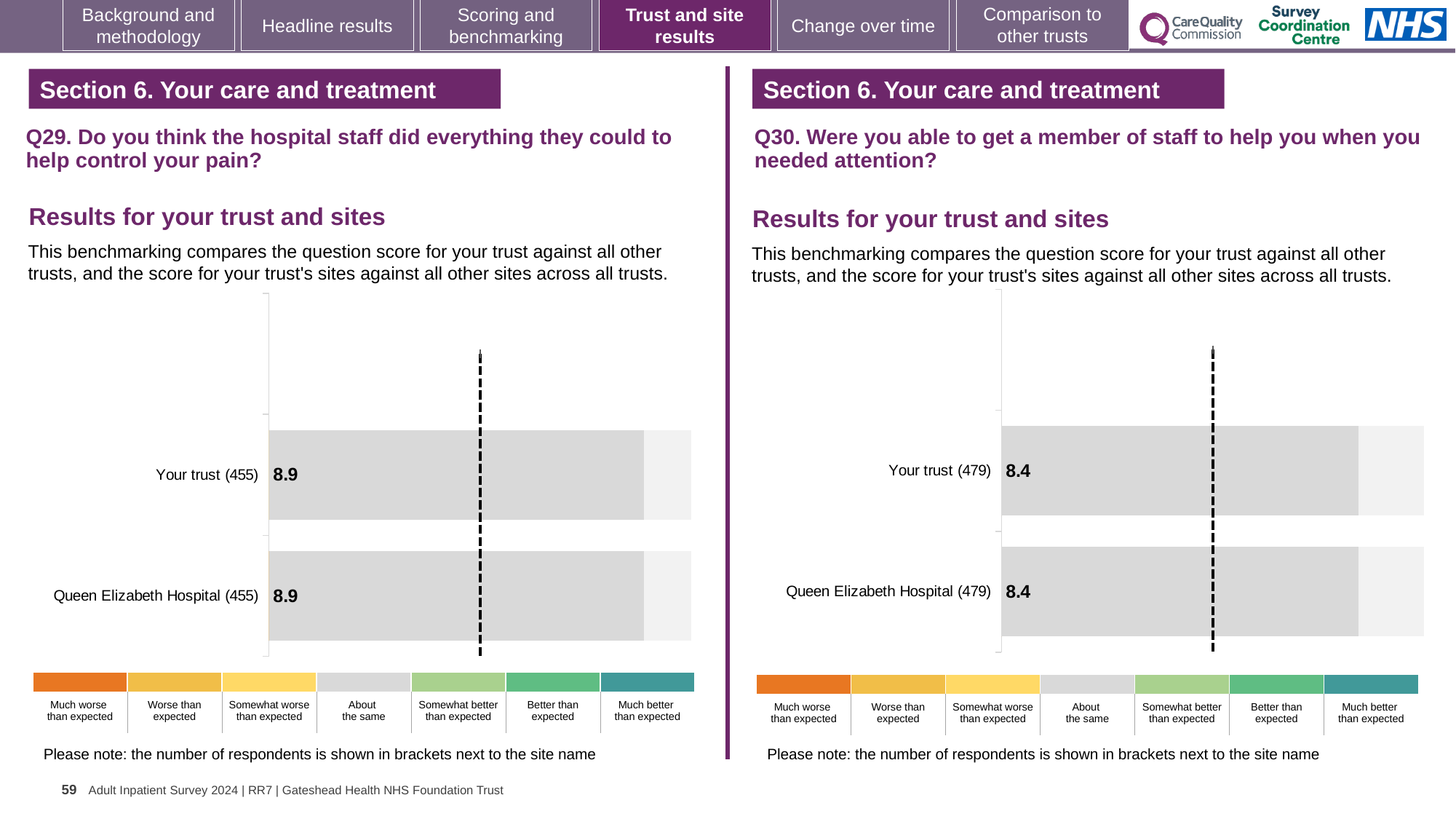
In the Q29 chart on the left, how many respondents are shown in brackets for Your trust? 455 In the Q30 chart on the right, what is the difference between the score for Your trust and the score for Queen Elizabeth Hospital? 0 Is the score for Your trust in the Q29 chart on the left larger or smaller than the score for Your trust in the Q30 chart on the right? Larger In the Q30 chart on the right, what is the score for Queen Elizabeth Hospital? 8.4 How many bars are plotted in the Q29 chart on the left? 2 How many bars are plotted in the Q30 chart on the right? 2 In the Q29 chart on the left, what is the difference between the score for Your trust and the score for Queen Elizabeth Hospital? 0 In the Q30 chart on the right, how many respondents are shown in brackets for Queen Elizabeth Hospital? 479 In the Q29 chart on the left, what is the score for Queen Elizabeth Hospital? 8.9 What kind of chart is used in the Q29 chart on the left? Bar chart In the Q30 chart on the right, what is the score for Your trust? 8.4 In the Q29 chart on the left, what is the score for Your trust? 8.9